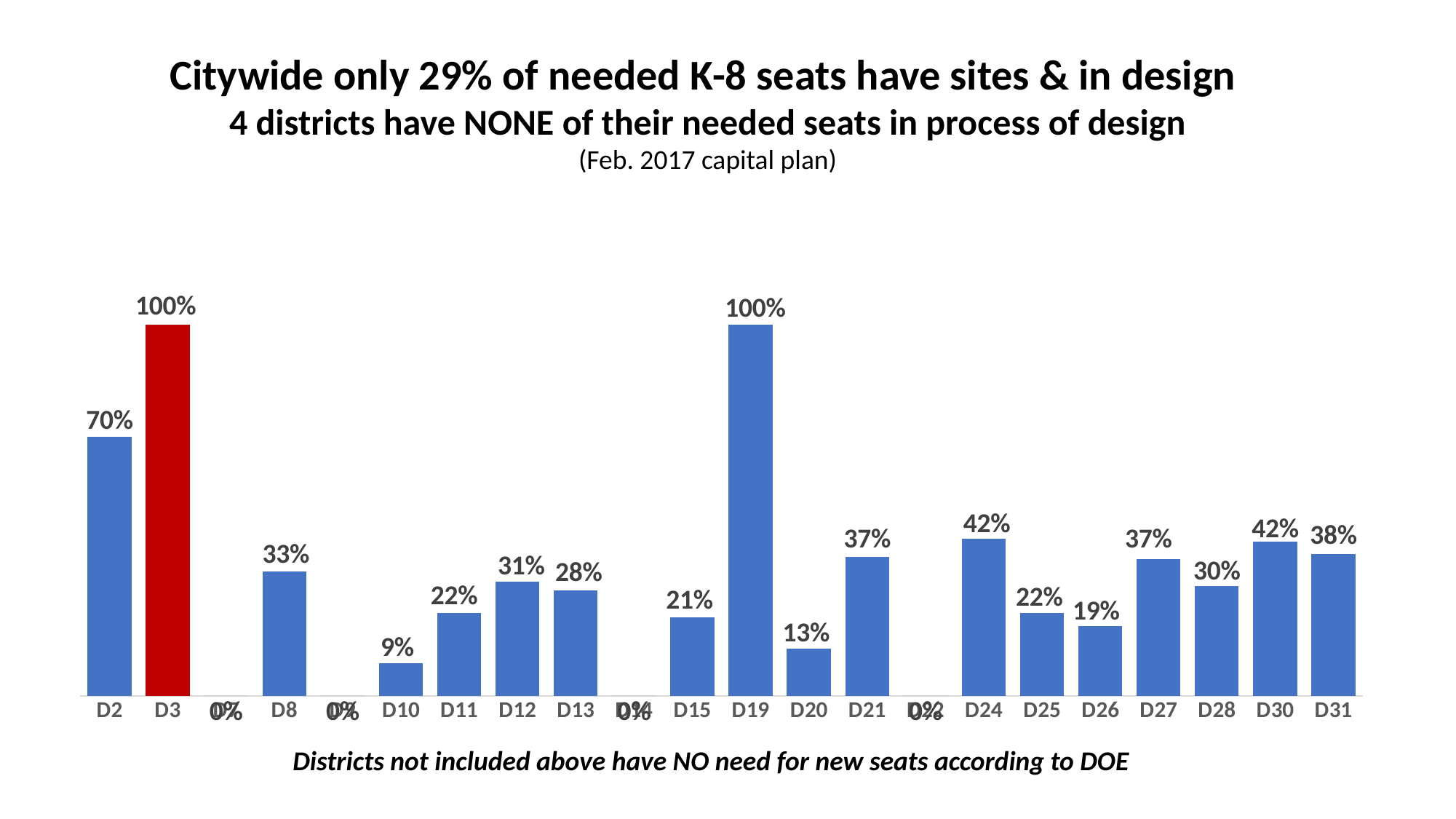
Which districts have the highest value on the chart? D3 and D19 Which has a larger value, D15 or D21? D21 According to the chart title, what percentage of needed K-8 seats citywide have sites and are in design? 29% What type of chart is shown on the slide? bar chart What is the difference between the values for D2 and D8? 37% What is the value for D2? 70% What is the value for D31? 38% What is the difference between the values for D24 and D26? 23% Which district's bar is coloured red instead of blue? D3 What is the value for D10? 9% What is the value for D20? 13% Which has a larger value, D12 or D13? D12